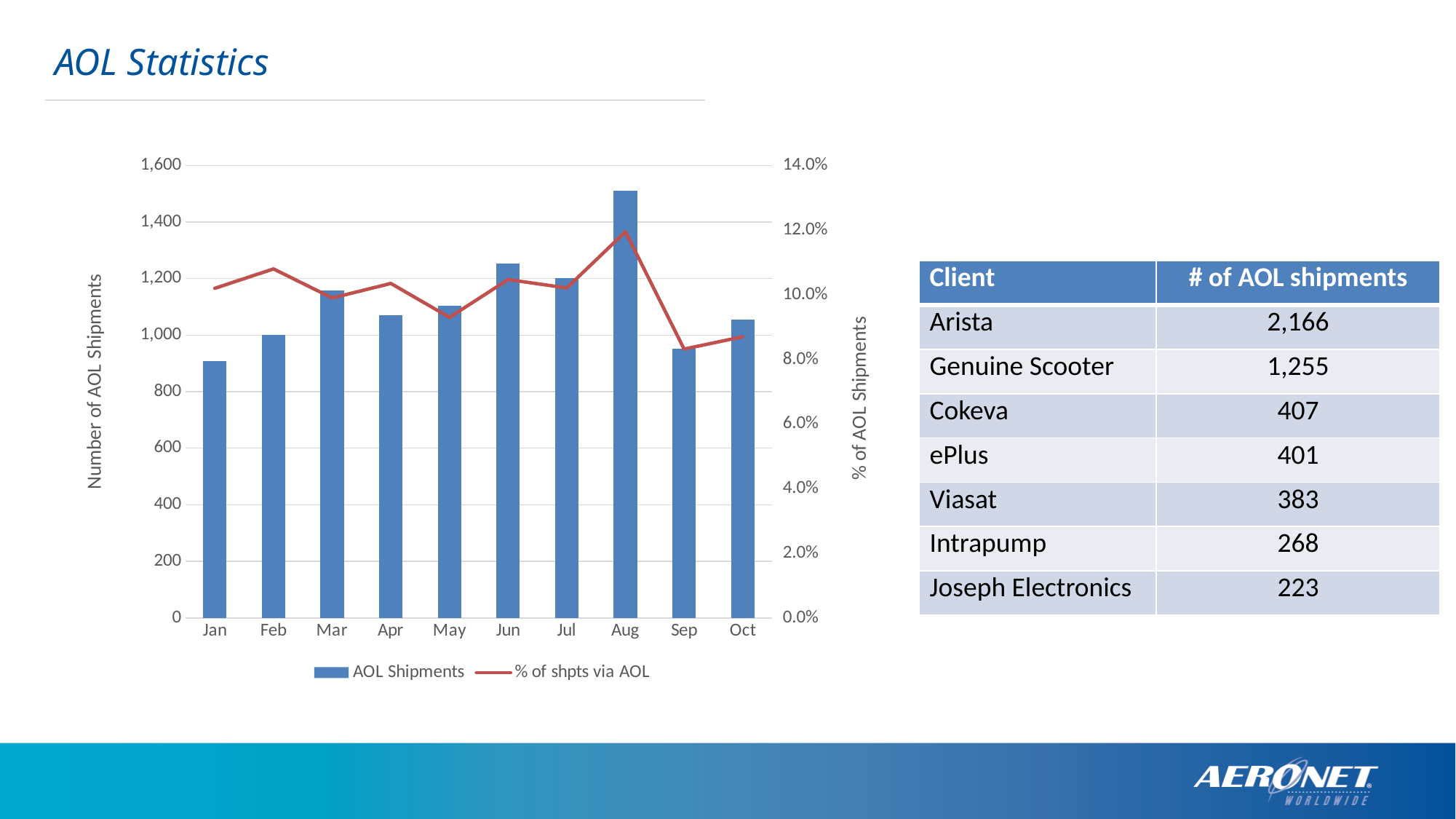
How many months are shown on the x axis of the chart? 10 Which month has the lowest number of AOL shipments? Jan What kind of chart is shown on the slide? A combined bar and line chart How many series does the chart legend list? 2 Is the % of shpts via AOL in Sep greater or less than 10.0%? less Which month has more AOL shipments, Mar or Apr? Mar What is the title of the left vertical axis of the chart? Number of AOL Shipments Is the number of AOL shipments in Aug greater or less than 1,400? greater Which month has the highest number of AOL shipments? Aug In which month does the % of shpts via AOL line reach its highest point? Aug Is the number of AOL shipments in Sep greater or less than 1,000? less